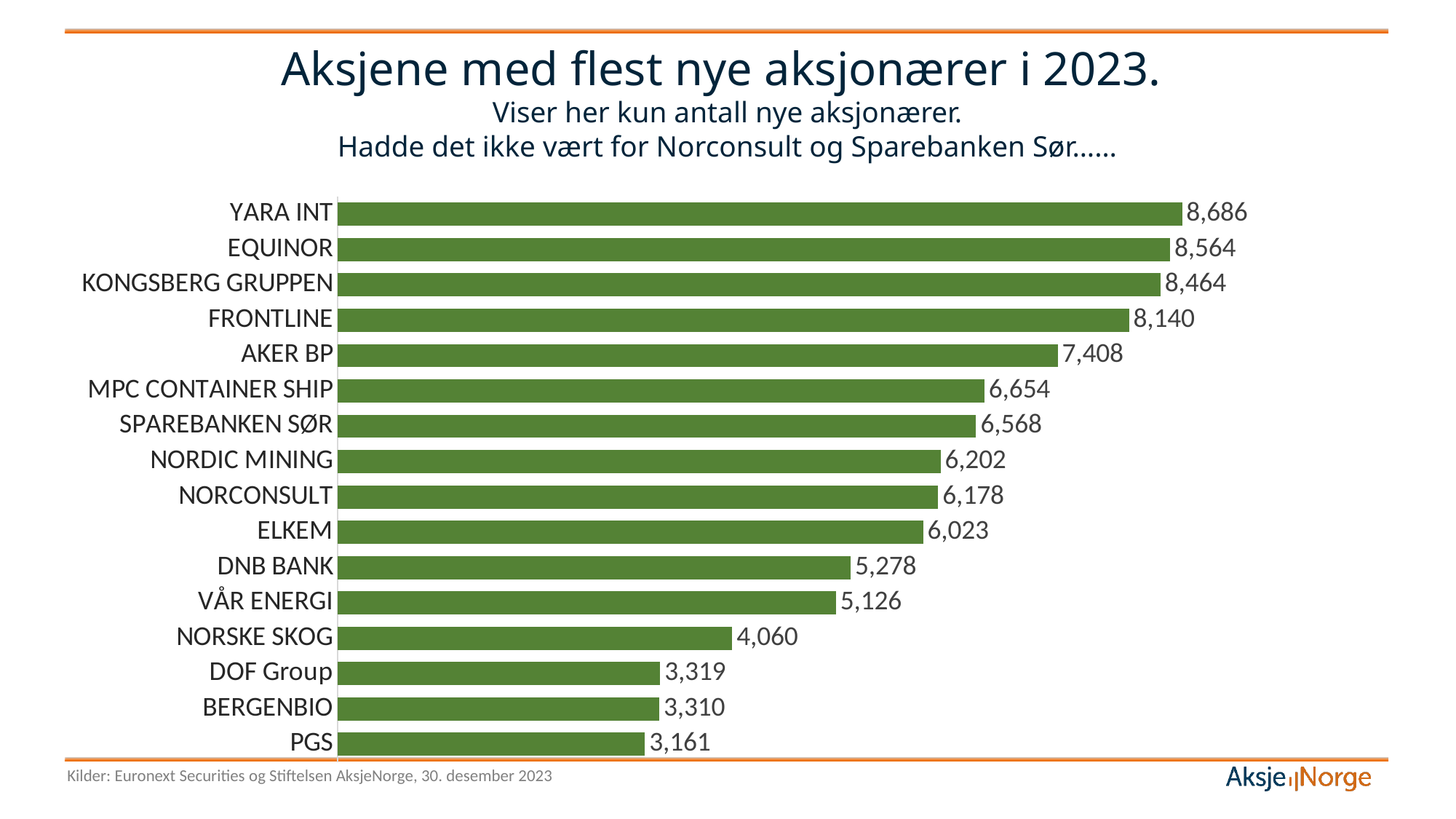
Which is larger, the value for FRONTLINE or the value for NORDIC MINING? FRONTLINE Which category has the highest value? YARA INT How many categories are shown in the chart? 16 Which is larger, the value for DNB BANK or the value for VÅR ENERGI? DNB BANK What kind of chart is shown on the slide? bar chart What is the value for EQUINOR? 8,564 What is the difference between the values for AKER BP and MPC CONTAINER SHIP? 754 What is the value for NORSKE SKOG? 4,060 What is the value for SPAREBANKEN SØR? 6,568 What is the title of the slide? Aksjene med flest nye aksjonærer i 2023. What is the difference between the values for YARA INT and PGS? 5,525 Which category has the lowest value? PGS